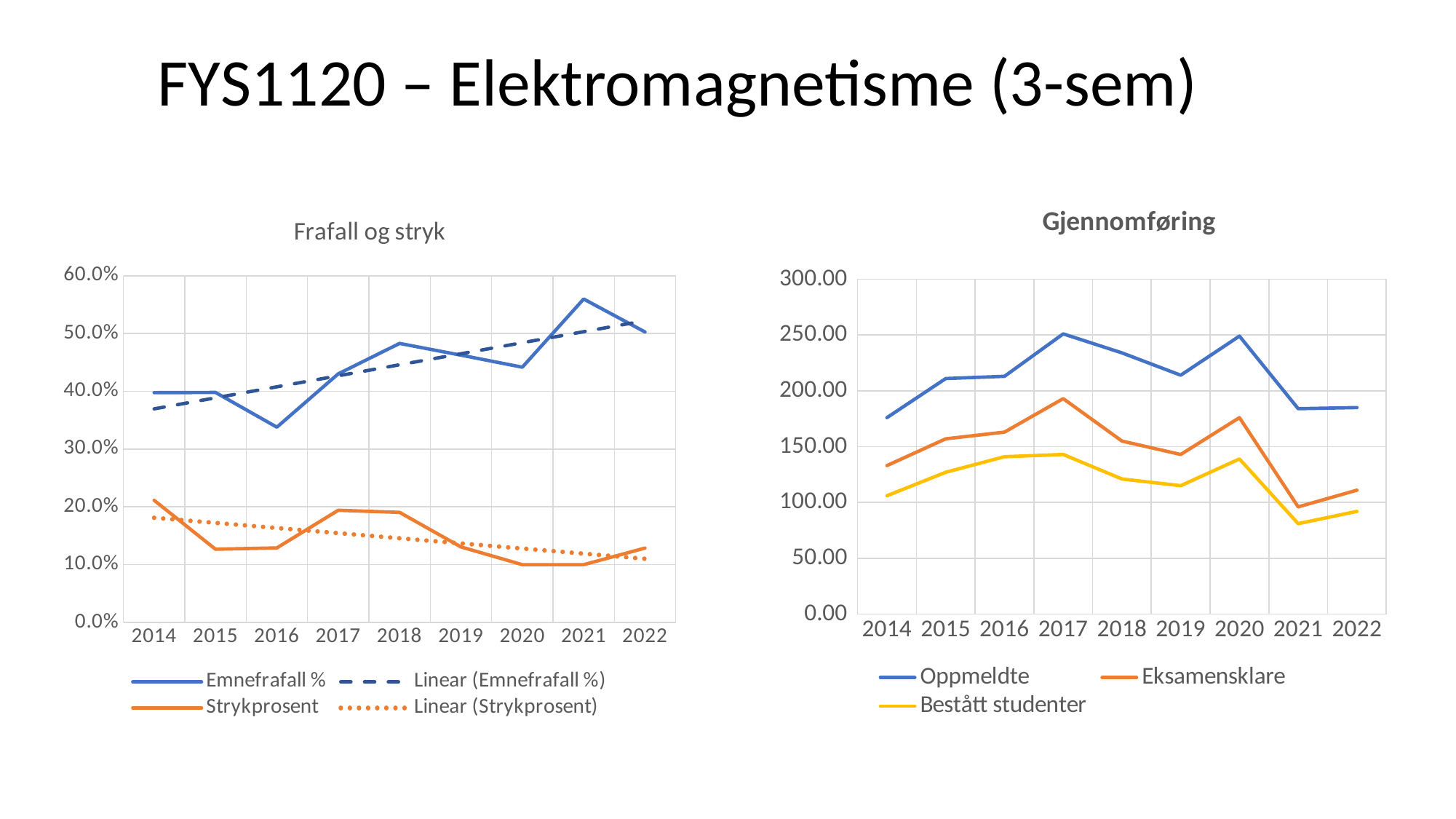
In the 'Frafall og stryk' chart, in which year is Strykprosent highest? 2014 In the 'Gjennomføring' chart, which is larger: Oppmeldte in 2017 or Oppmeldte in 2021? 2017 In the 'Gjennomføring' chart, how many series does the legend list? 3 In the 'Frafall og stryk' chart, is the value for Emnefrafall % in 2021 greater or less than 50.0%? greater In the 'Frafall og stryk' chart, does the Linear (Strykprosent) trend line rise or fall from 2014 to 2022? fall In the 'Gjennomføring' chart, in which year is Eksamensklare highest? 2017 In the 'Gjennomføring' chart, is the value for Oppmeldte in 2014 greater or less than 200.00? less In the 'Frafall og stryk' chart, in which year is Emnefrafall % lowest? 2016 In the 'Frafall og stryk' chart, how many entries does the legend list? 4 In the 'Frafall og stryk' chart, in which year is Emnefrafall % highest? 2021 What kind of chart is the 'Frafall og stryk' chart? line chart How many years are shown on the x axis of the 'Gjennomføring' chart? 9